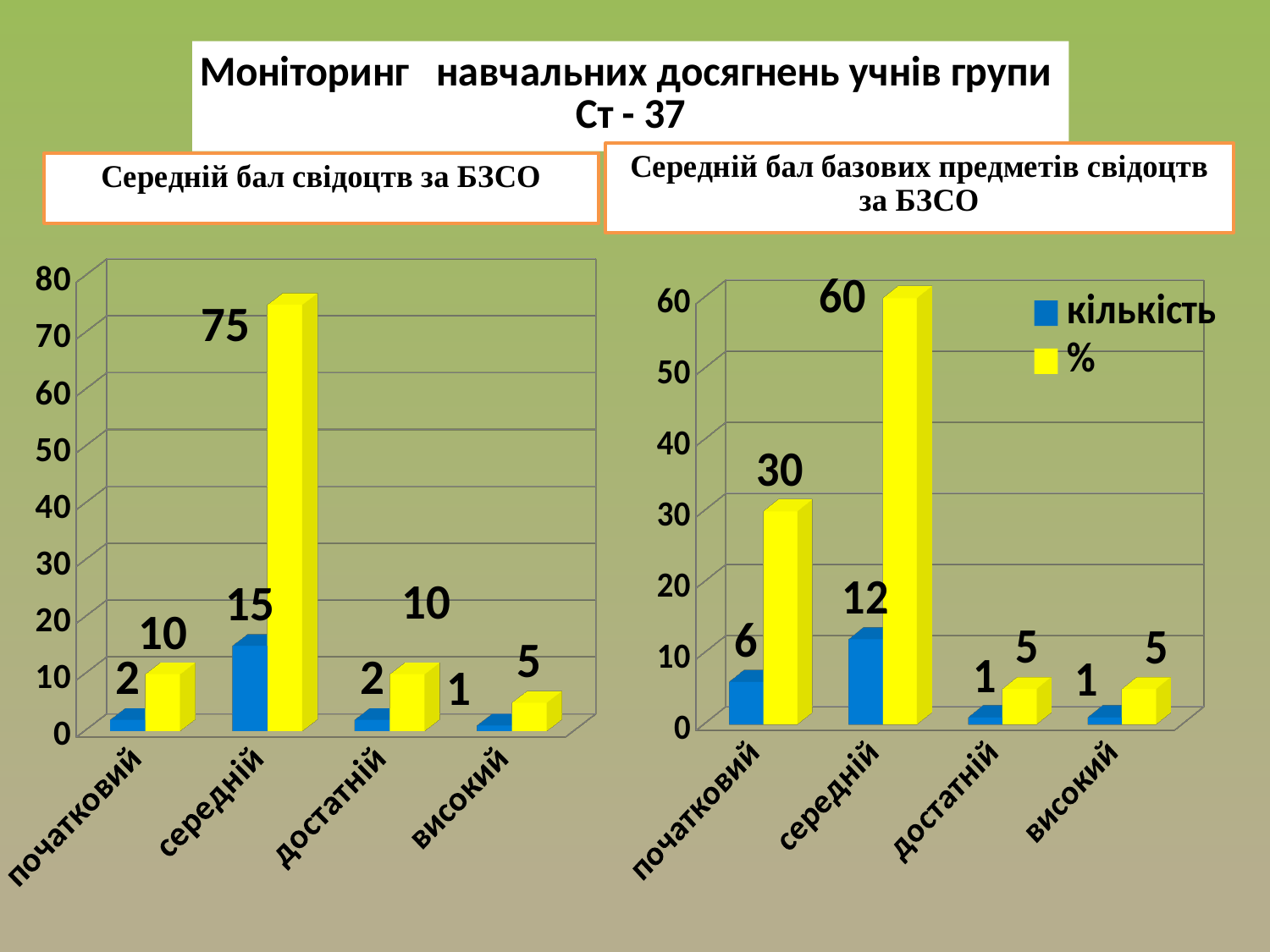
In the right chart 'Середній бал базових предметів свідоцтв за БЗСО', what is the 'кількість' value for 'середній'? 12 How many series does the legend of the right chart 'Середній бал базових предметів свідоцтв за БЗСО' list? 2 In the left chart 'Середній бал свідоцтв за БЗСО', what is the value of the blue bar for 'високий'? 1 In the right chart 'Середній бал базових предметів свідоцтв за БЗСО', which category has the highest '%' value? середній In the right chart 'Середній бал базових предметів свідоцтв за БЗСО', what is the difference between the 'кількість' values for 'середній' and 'початковий'? 6 In the right chart 'Середній бал базових предметів свідоцтв за БЗСО', what is the '%' value for 'початковий'? 30 How many categories are shown on the x axis of the left chart 'Середній бал свідоцтв за БЗСО'? 4 In the left chart 'Середній бал свідоцтв за БЗСО', which category has the lowest yellow bar value? високий What type of chart is the right chart 'Середній бал базових предметів свідоцтв за БЗСО'? bar chart In the right chart 'Середній бал базових предметів свідоцтв за БЗСО', which is larger: the '%' value for 'початковий' or for 'достатній'? початковий In the left chart 'Середній бал свідоцтв за БЗСО', what is the value of the yellow bar for 'середній'? 75 In the left chart 'Середній бал свідоцтв за БЗСО', what is the difference between the yellow bar values for 'середній' and 'початковий'? 65